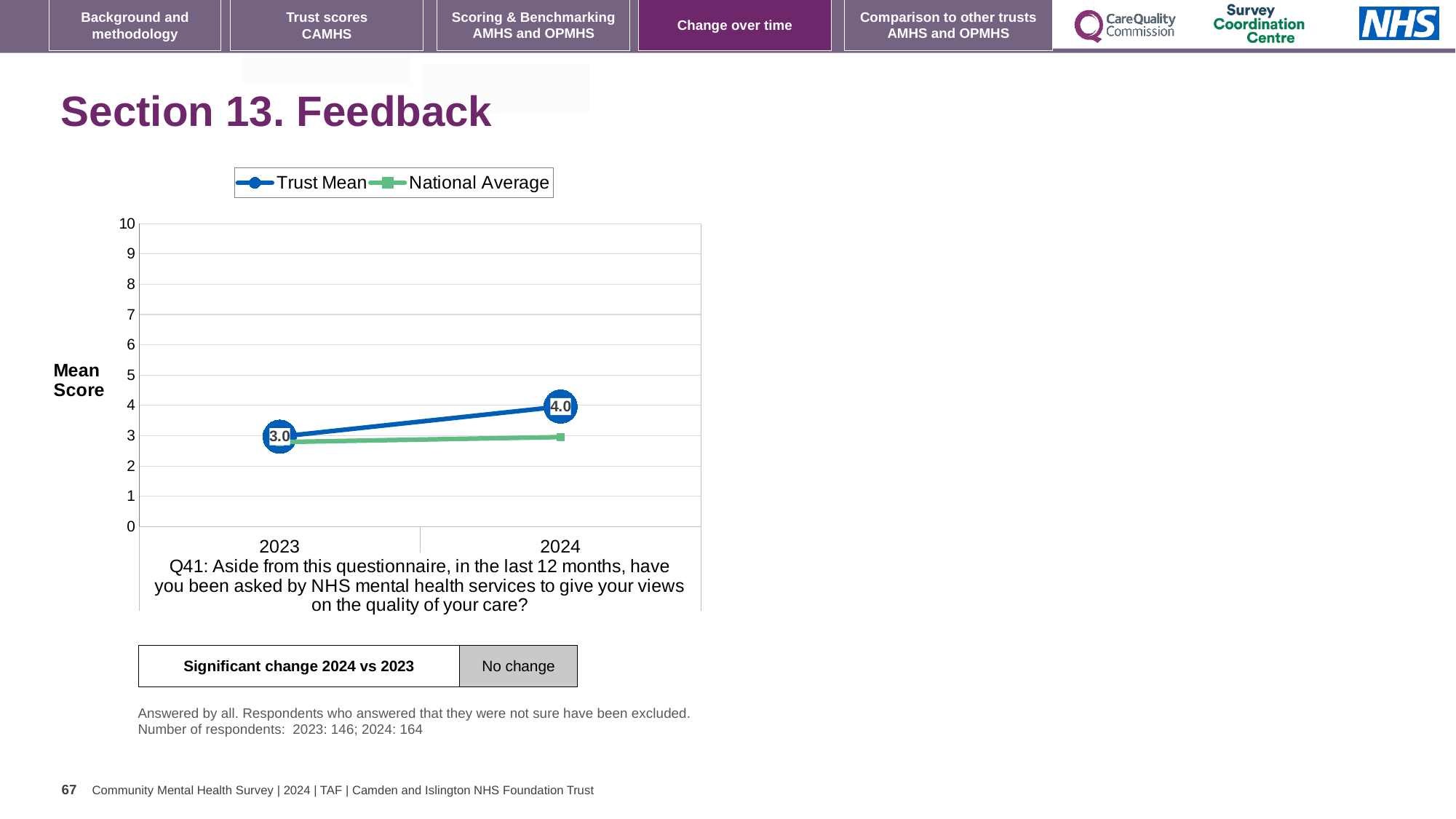
How many series does the legend list? 2 What is the Trust Mean value for 2024? 4.0 What is the Trust Mean value for 2023? 3.0 What kind of chart is shown on the slide? line chart What are the two series named in the legend? Trust Mean and National Average In which year is the Trust Mean higher? 2024 In 2024, which is larger: the Trust Mean or the National Average? Trust Mean How many years are plotted on the x axis? 2 Does the Trust Mean rise or fall from 2023 to 2024? rise What is the label on the y axis? Mean Score By how much did the Trust Mean change from 2023 to 2024? 1.0 Is the National Average value for 2024 greater or less than 5? less